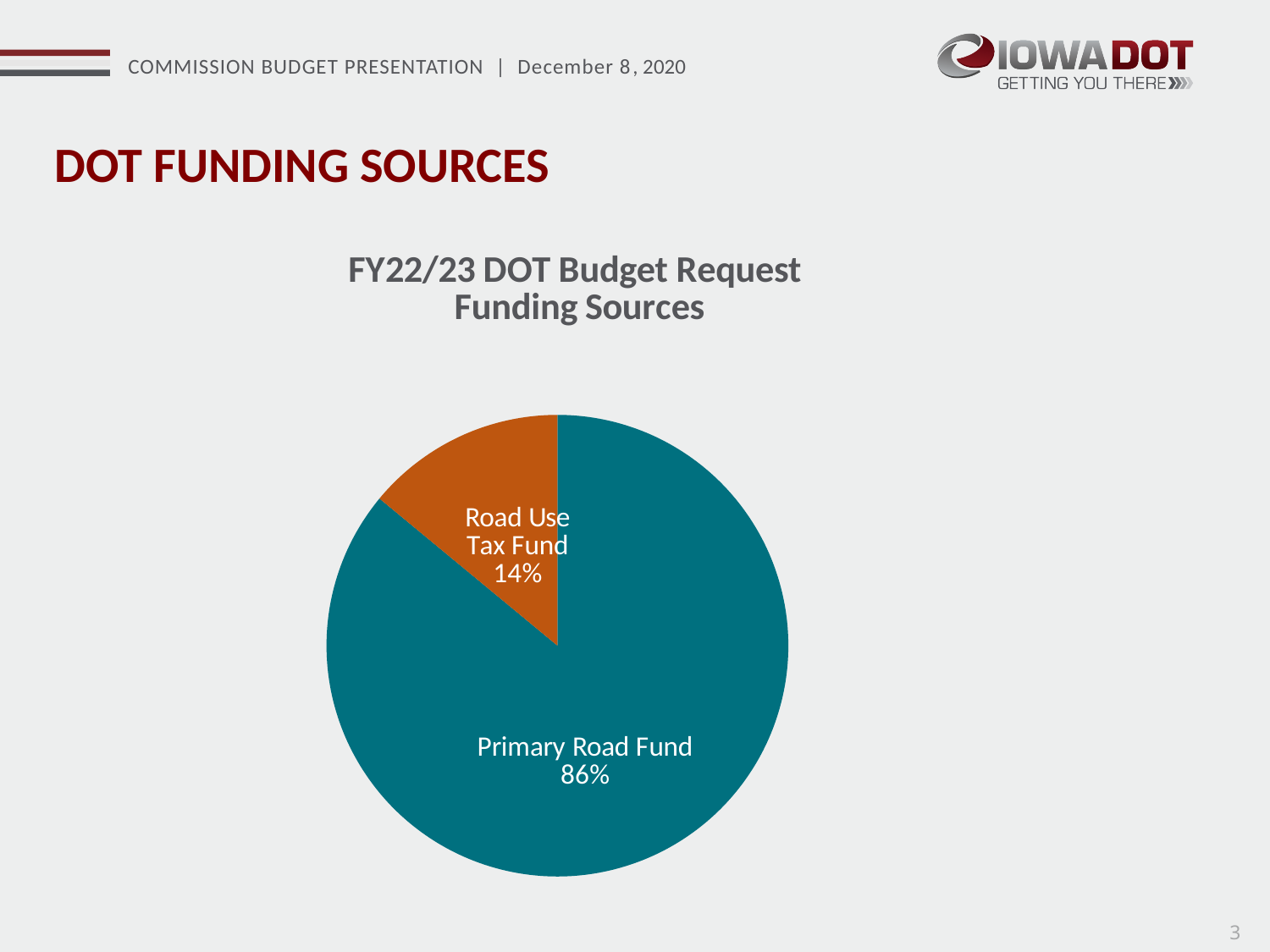
Which funding source has the smallest share? Road Use Tax Fund What kind of chart is shown on the slide? pie chart Which funding source has the largest share? Primary Road Fund What share of the pie does the Primary Road Fund represent? 86% What share of the pie does the Road Use Tax Fund represent? 14% What is the title of the chart? FY22/23 DOT Budget Request Funding Sources What is the difference in percentage points between the Primary Road Fund and the Road Use Tax Fund shares? 72 Which is larger, the Road Use Tax Fund share or the Primary Road Fund share? Primary Road Fund What colour is the Road Use Tax Fund slice? orange How many slices does the pie chart have? 2 What is the total of the two slices' percentages? 100%